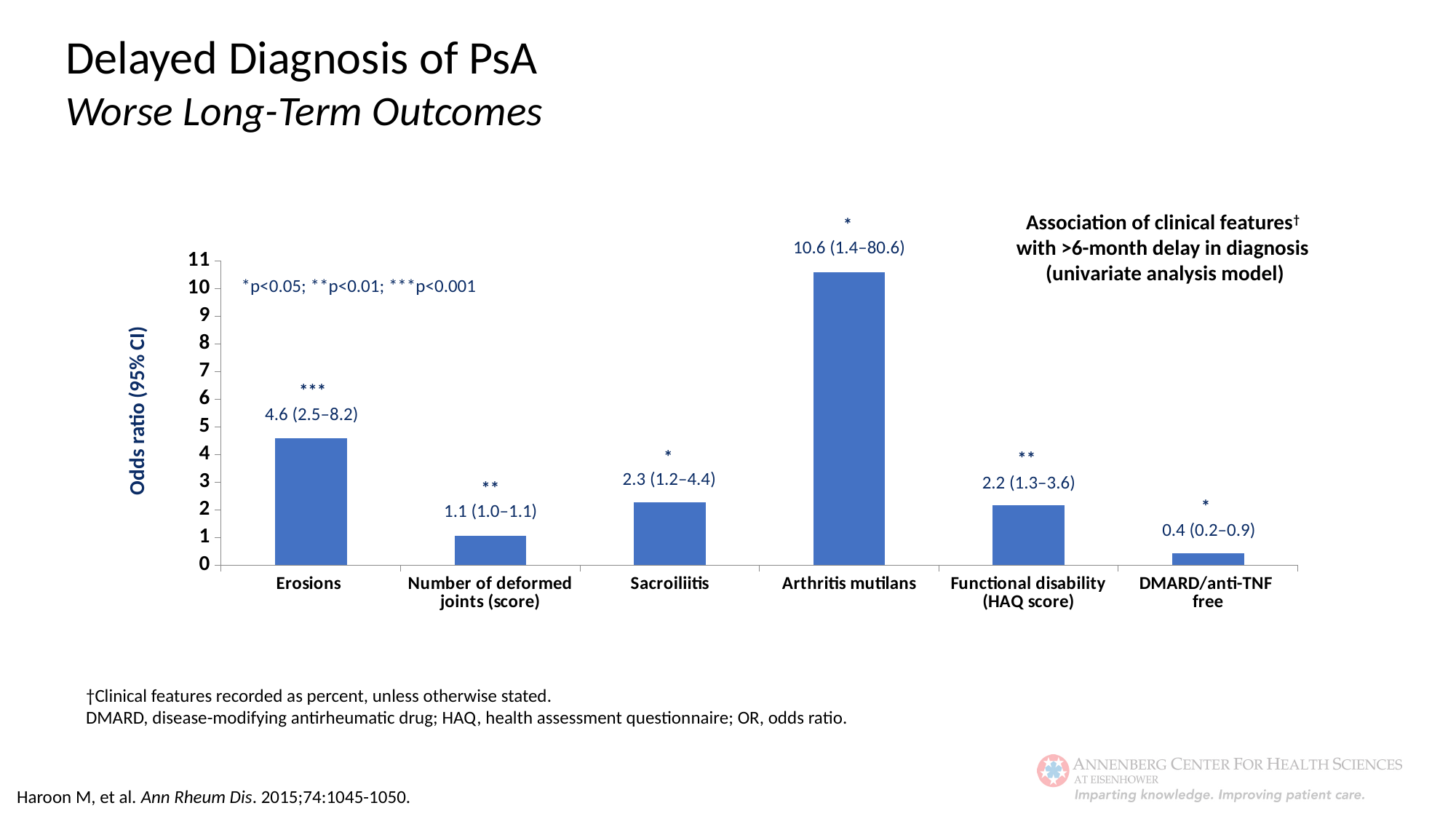
What kind of chart is shown on the slide? Bar chart What is the 95% CI shown for Functional disability (HAQ score)? 1.3–3.6 What is the odds ratio for Arthritis mutilans? 10.6 What is the odds ratio for DMARD/anti-TNF free? 0.4 Which has a larger odds ratio, Sacroiliitis or Number of deformed joints (score)? Sacroiliitis Is the odds ratio for Arthritis mutilans greater or less than 10? greater How many clinical features are plotted on the chart? 6 Which clinical feature has the highest odds ratio? Arthritis mutilans Which clinical feature has the lowest odds ratio? DMARD/anti-TNF free What is the label of the y axis? Odds ratio (95% CI) What is the odds ratio for Erosions? 4.6 What is the difference between the odds ratios for Erosions and Sacroiliitis? 2.3